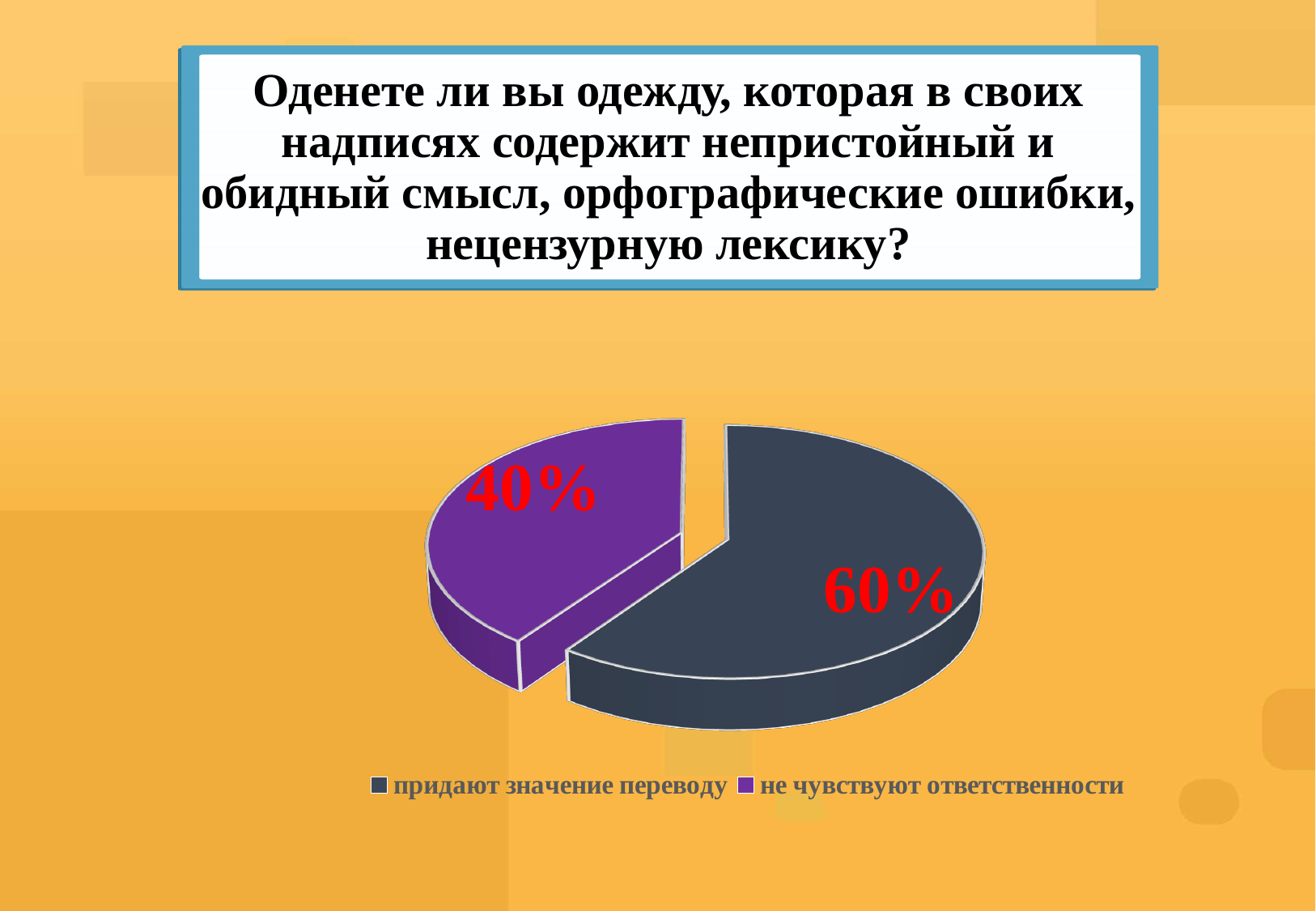
What kind of chart is shown on the slide? pie chart How many entries does the legend list? 2 What colour is the slice for "придают значение переводу"? dark grey What percentage is shown for the slice labelled "придают значение переводу"? 60% Which slice is larger: "придают значение переводу" or "не чувствуют ответственности"? придают значение переводу Which category has the smallest share of the pie? не чувствуют ответственности What percentage is shown for the slice labelled "не чувствуют ответственности"? 40% What is the total of the two slices shown? 100% Which category has the largest share of the pie? придают значение переводу What is the difference in percentage points between the two slices? 20% How many slices does the pie chart have? 2 What share of the pie does the purple slice represent? 40%